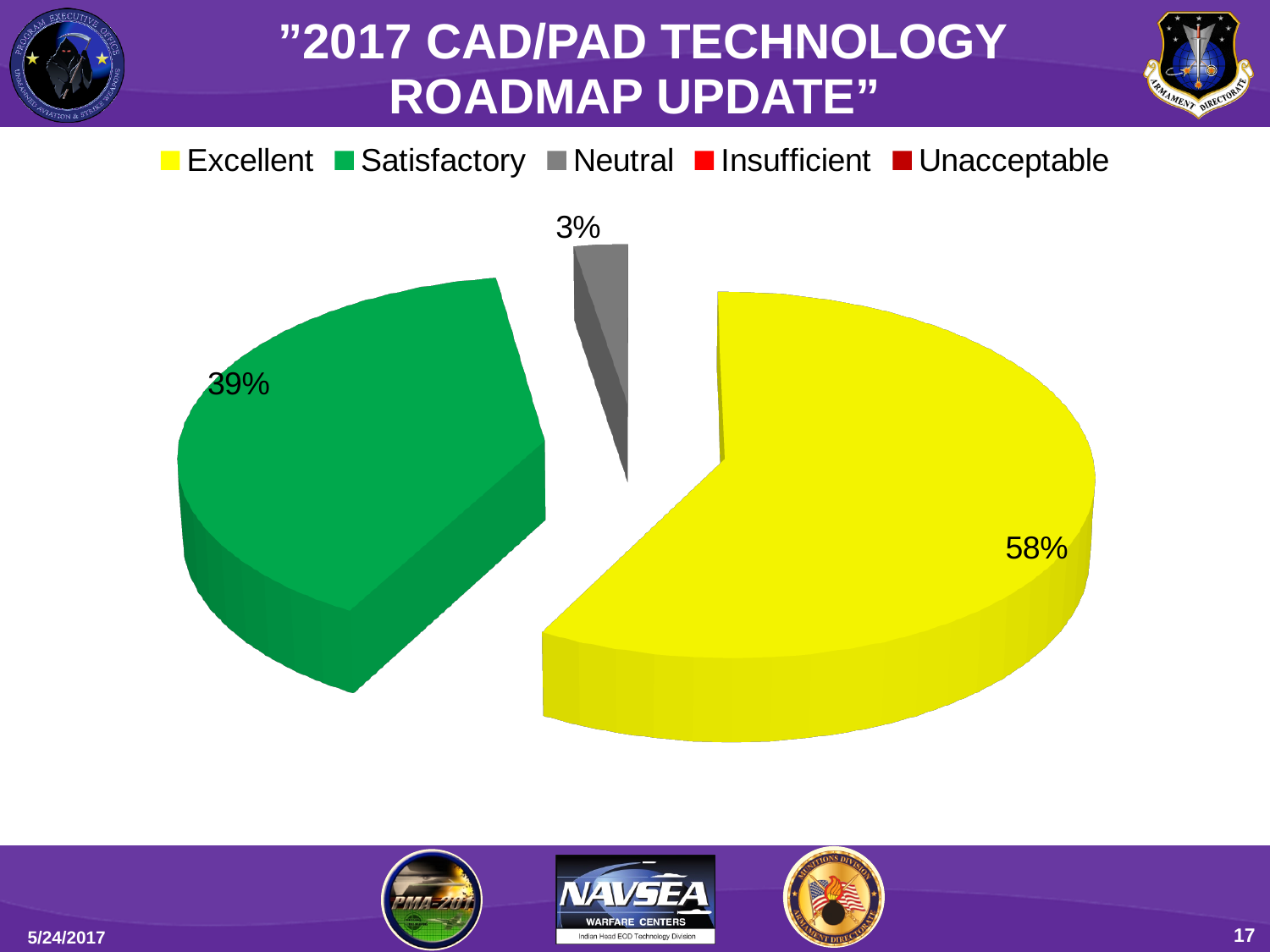
Which category has the largest slice of the pie? Excellent How many slices of the pie have a percentage label? 3 How many categories does the legend list? 5 What is the combined share of the Excellent and Satisfactory slices? 97% Which of the labelled slices is the smallest? Neutral What share of the pie does the Satisfactory slice represent? 39% What colour is the Excellent slice? yellow What share of the pie does the Neutral slice represent? 3% What is the difference in percentage points between the Excellent and Satisfactory slices? 19 What kind of chart is shown on the slide? pie chart What share of the pie does the Excellent slice represent? 58% Which slice is larger, Satisfactory or Neutral? Satisfactory